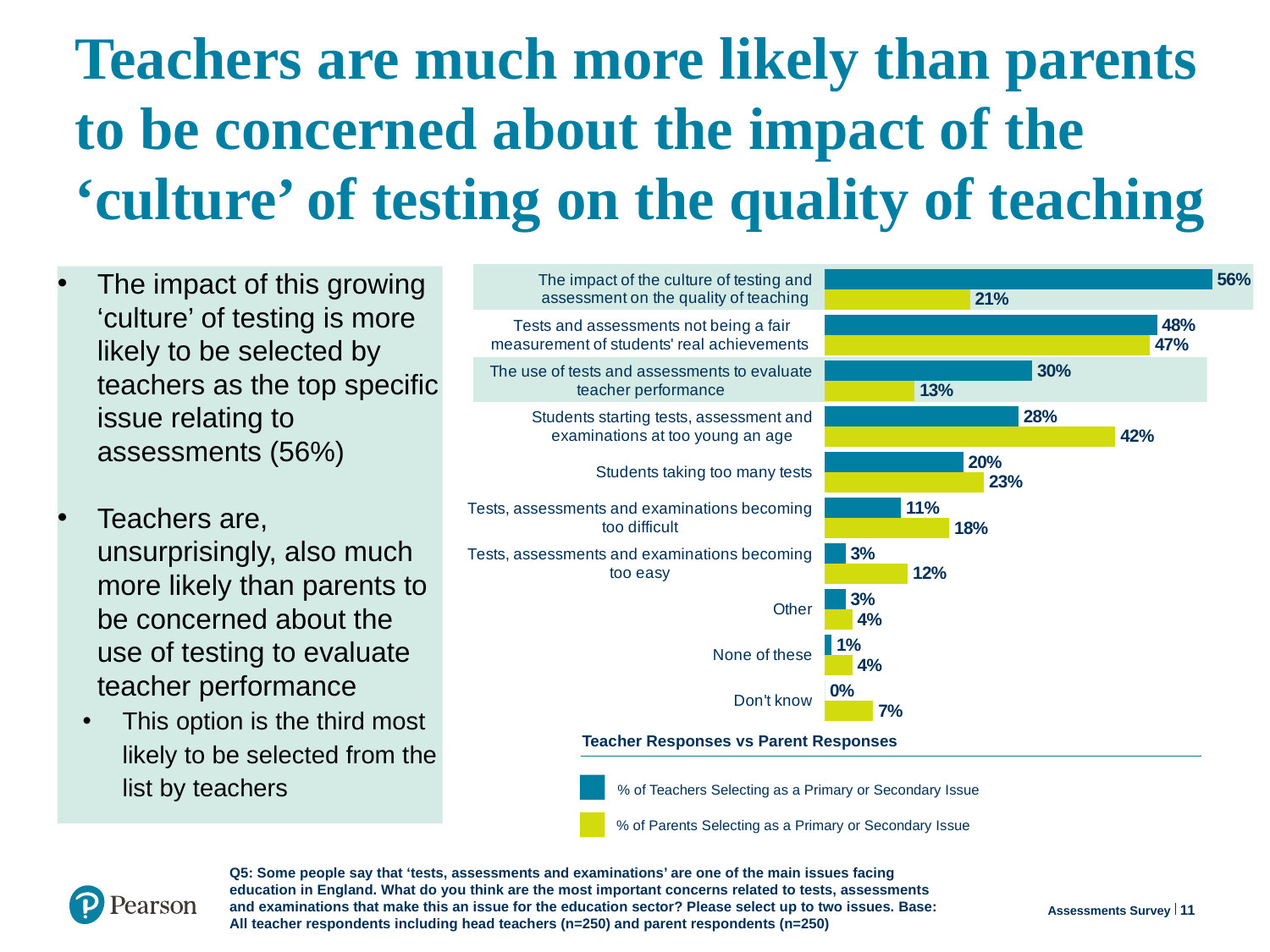
How many series does the legend list? 2 How many categories are shown in the chart? 10 Which category has the lowest value for teachers? Don't know What is the difference between the teacher and parent percentages for 'The use of tests and assessments to evaluate teacher performance'? 17% What kind of chart is shown on the slide? Bar chart What percentage of parents selected 'Don't know'? 7% Which category has the highest value for parents? Tests and assessments not being a fair measurement of students' real achievements What is the title of the chart? Teacher Responses vs Parent Responses For 'Students taking too many tests', which is larger: the teacher percentage or the parent percentage? Parent percentage Which category has the highest value for teachers? The impact of the culture of testing and assessment on the quality of teaching What percentage of teachers selected 'The impact of the culture of testing and assessment on the quality of teaching' as a primary or secondary issue? 56% What percentage of parents selected 'Students starting tests, assessment and examinations at too young an age'? 42%